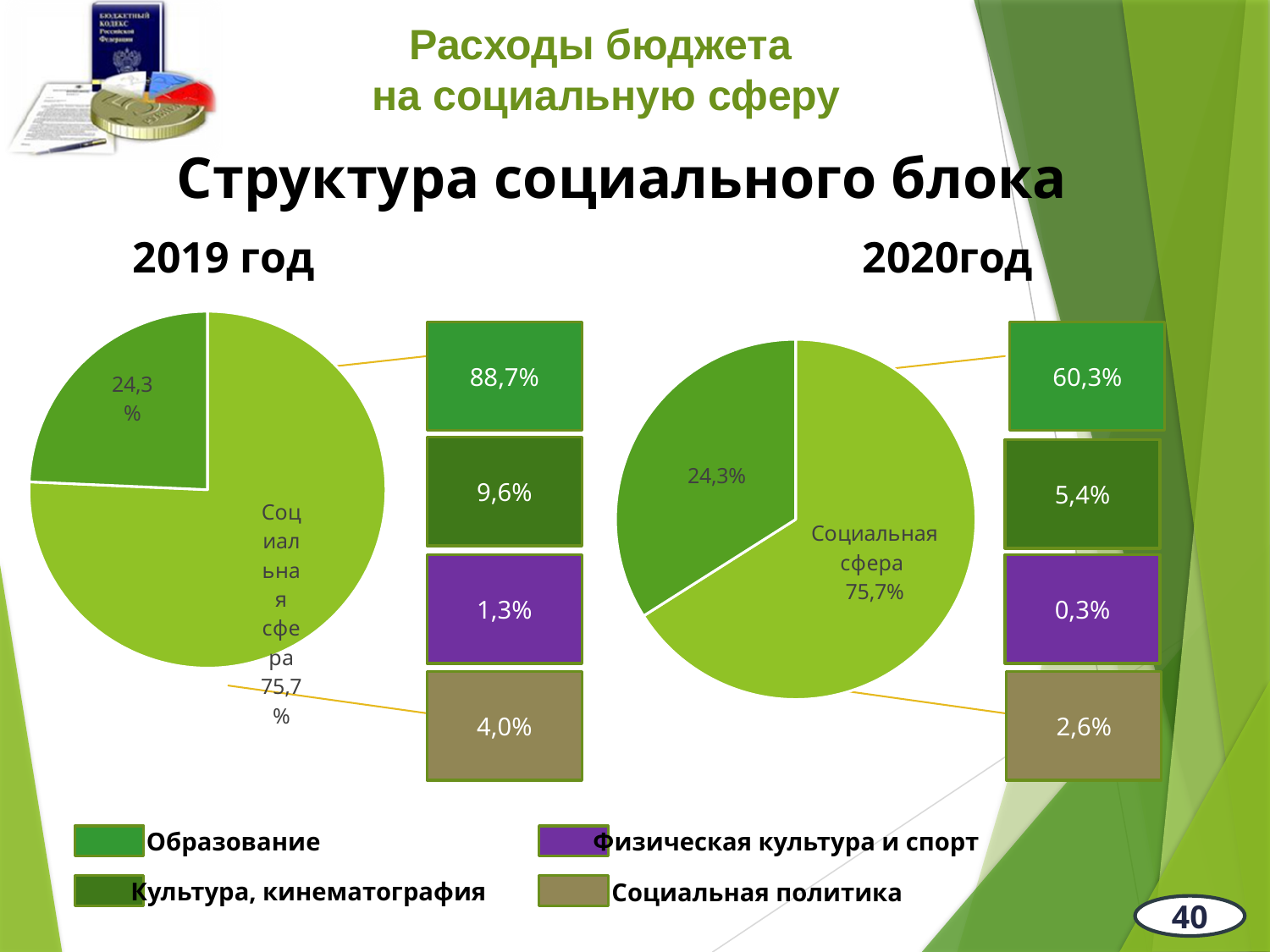
In the 2020год pie chart, what is the value of the smaller slice? 24,3% In the 2020год chart, what percentage is shown in the box for Образование? 60,3% In the 2020год pie chart, what share is labelled Социальная сфера? 75,7% How many slices does the 2019 год pie chart have? 2 What kind of chart is used for the 2019 год chart? pie chart In the 2019 год chart, which slice is larger: Социальная сфера or the other slice? Социальная сфера In the 2019 год chart, what percentage is shown in the box for Образование? 88,7% In the 2019 год chart, what percentage is shown in the box for Физическая культура и спорт? 1,3% In the 2019 год chart, what is the difference between the Социальная сфера slice and the other slice? 51,4% How many categories does the legend at the bottom of the slide list? 4 In the 2020год chart, what percentage is shown in the box for Социальная политика? 2,6% In the 2019 год pie chart, what share is labelled Социальная сфера? 75,7%